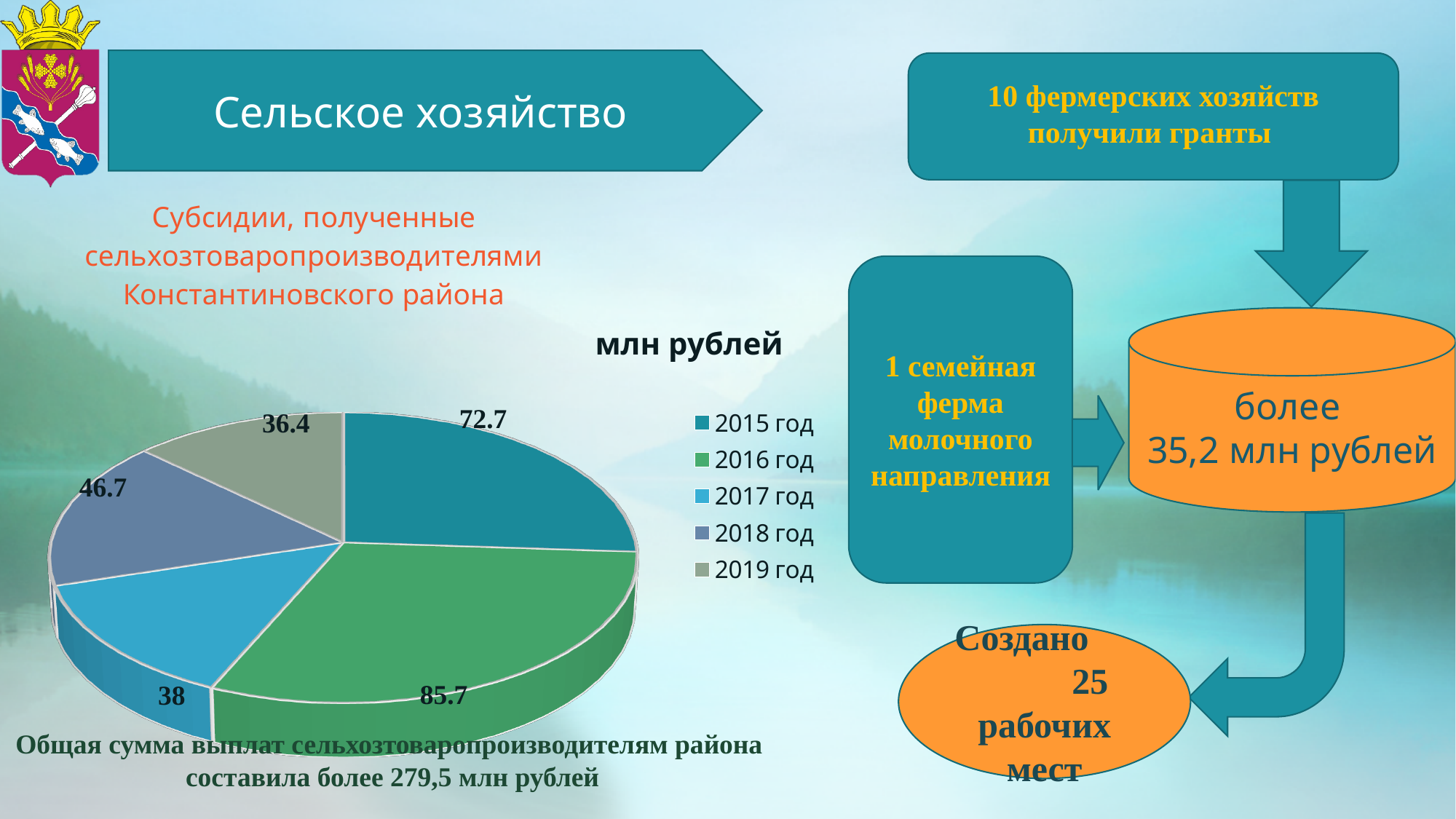
What is the value for 2017 год in the pie chart? 38 What is the value for 2016 год in the pie chart? 85.7 What is the difference between the values for 2018 год and 2017 год? 8.7 What type of chart is shown on the slide? pie chart How many slices does the pie chart have? 5 Which is larger, the value for 2018 год or the value for 2019 год? 2018 год Which year has the smallest slice in the pie chart? 2019 год Which year has the largest slice in the pie chart? 2016 год What is the value for 2015 год in the pie chart? 72.7 What unit is given in the chart title above the legend? млн рублей What is the difference between the values for 2016 год and 2015 год? 13 What is the value for 2019 год in the pie chart? 36.4